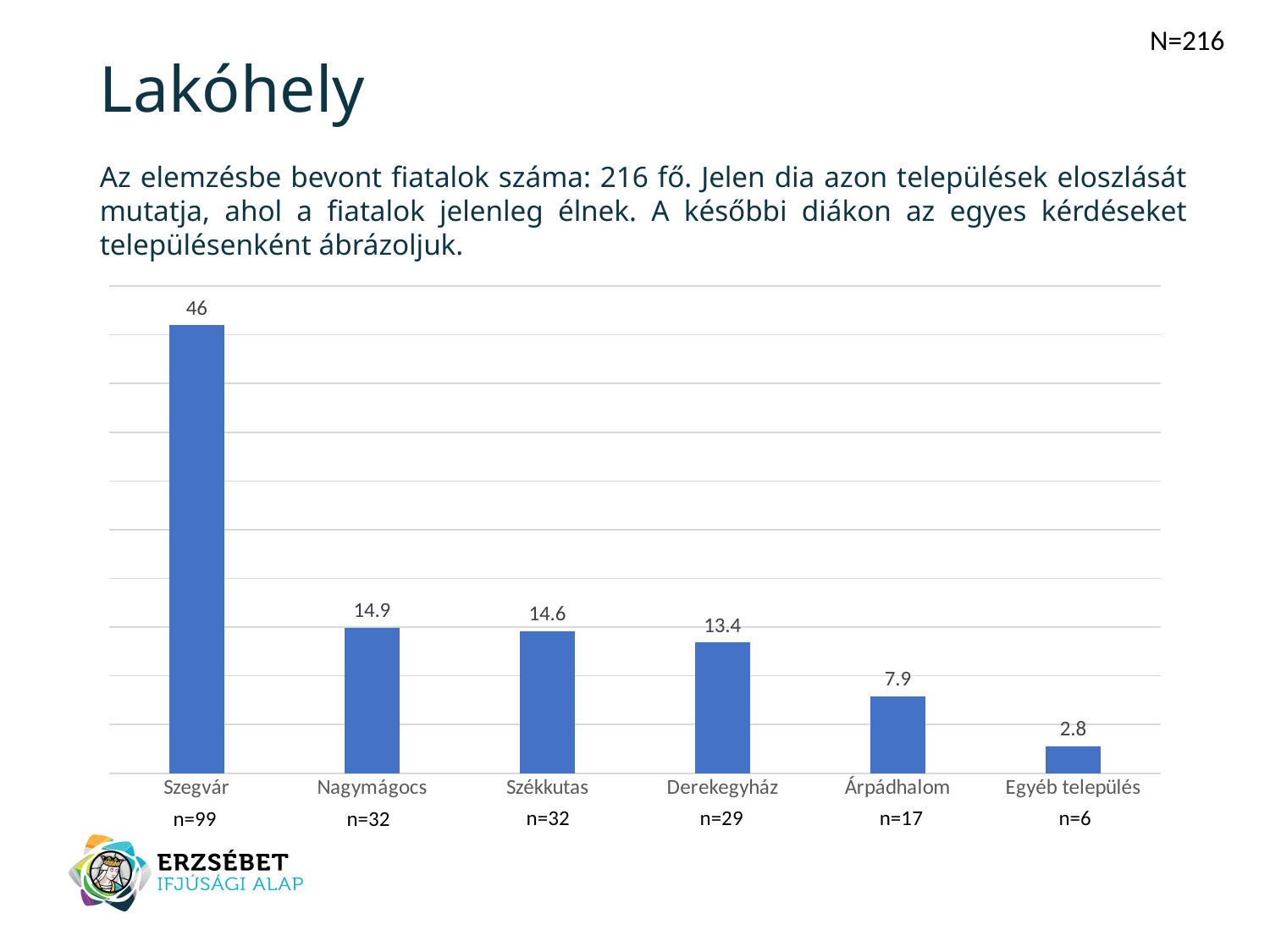
What is the difference between the values for Szegvár and Nagymágocs? 31.1 What is the value for Árpádhalom? 7.9 What kind of chart is shown on the slide? Bar chart How many categories are shown on the x axis? 6 Which is larger, the value for Derekegyház or the value for Árpádhalom? Derekegyház What is the value for Derekegyház? 13.4 What is the value for Egyéb település? 2.8 What is the value for Nagymágocs? 14.9 Which category has the lowest value? Egyéb település Do the values rise or fall from left to right along the x axis? Fall What is the value for Szegvár? 46 Which category has the highest value? Szegvár